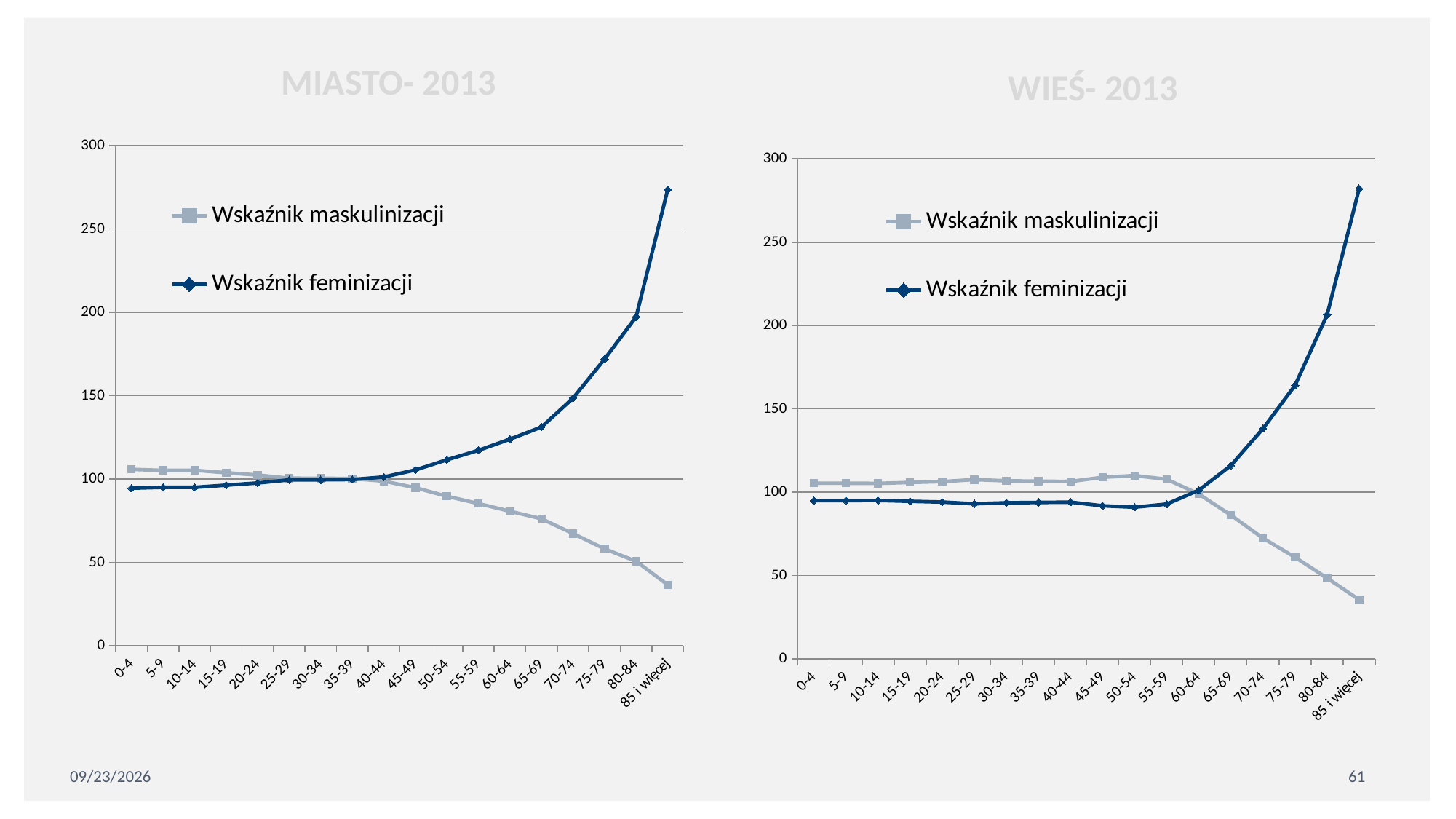
In the WIEŚ- 2013 chart, does Wskaźnik maskulinizacji rise or fall from 60-64 to 85 i więcej? fall What is the title of the chart on the right side of the slide? WIEŚ- 2013 What kind of chart is the MIASTO- 2013 chart? line chart In the MIASTO- 2013 chart, which series has the higher value for 0-4, Wskaźnik maskulinizacji or Wskaźnik feminizacji? Wskaźnik maskulinizacji In the WIEŚ- 2013 chart, is the value of Wskaźnik feminizacji for 75-79 greater or less than 150? greater How many series does the legend of the WIEŚ- 2013 chart list? 2 In the MIASTO- 2013 chart, is the value of Wskaźnik feminizacji for 85 i więcej greater or less than 250? greater In the MIASTO- 2013 chart, for which age category is Wskaźnik maskulinizacji lowest? 85 i więcej In the MIASTO- 2013 chart, is the value of Wskaźnik maskulinizacji for 85 i więcej greater or less than 50? less How many age categories are shown on the x axis of the MIASTO- 2013 chart? 18 In the WIEŚ- 2013 chart, for which age category is Wskaźnik feminizacji highest? 85 i więcej